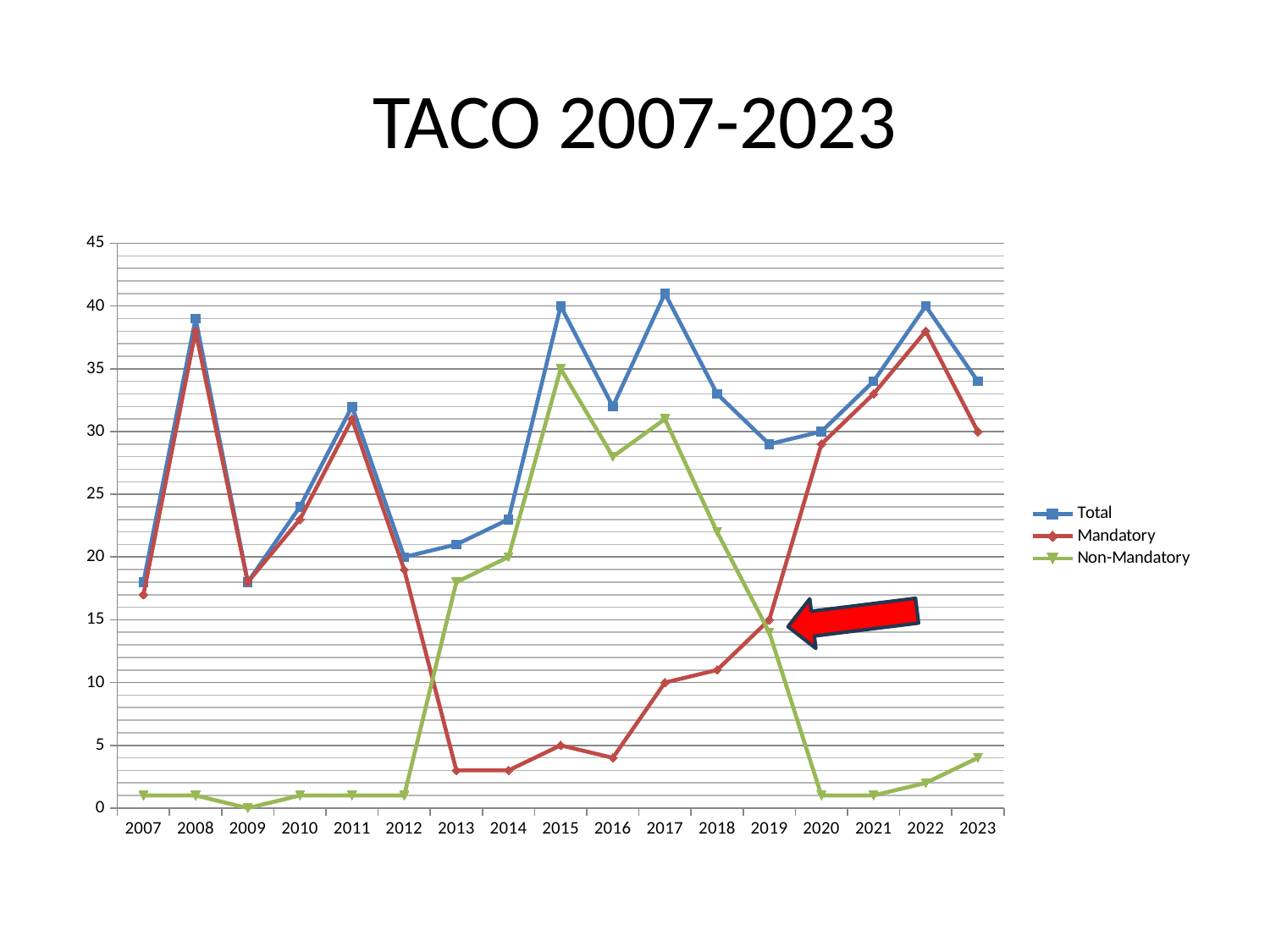
What is the title of the chart? TACO 2007-2023 In 2015, which is larger: Mandatory or Non-Mandatory? Non-Mandatory What is the Total value in 2015? 40 Is the Mandatory value in 2013 greater or less than 5? less How many series does the legend list? 3 In which year is the Non-Mandatory series at its highest? 2015 How many years are plotted along the x axis? 17 In which year is the Non-Mandatory series at its lowest? 2009 What kind of chart is shown on the slide? line chart Does the Non-Mandatory series rise or fall from 2017 to 2020? fall Is the Non-Mandatory value in 2016 greater or less than 25? greater What is the Mandatory value in 2019, where the red arrow points? 15